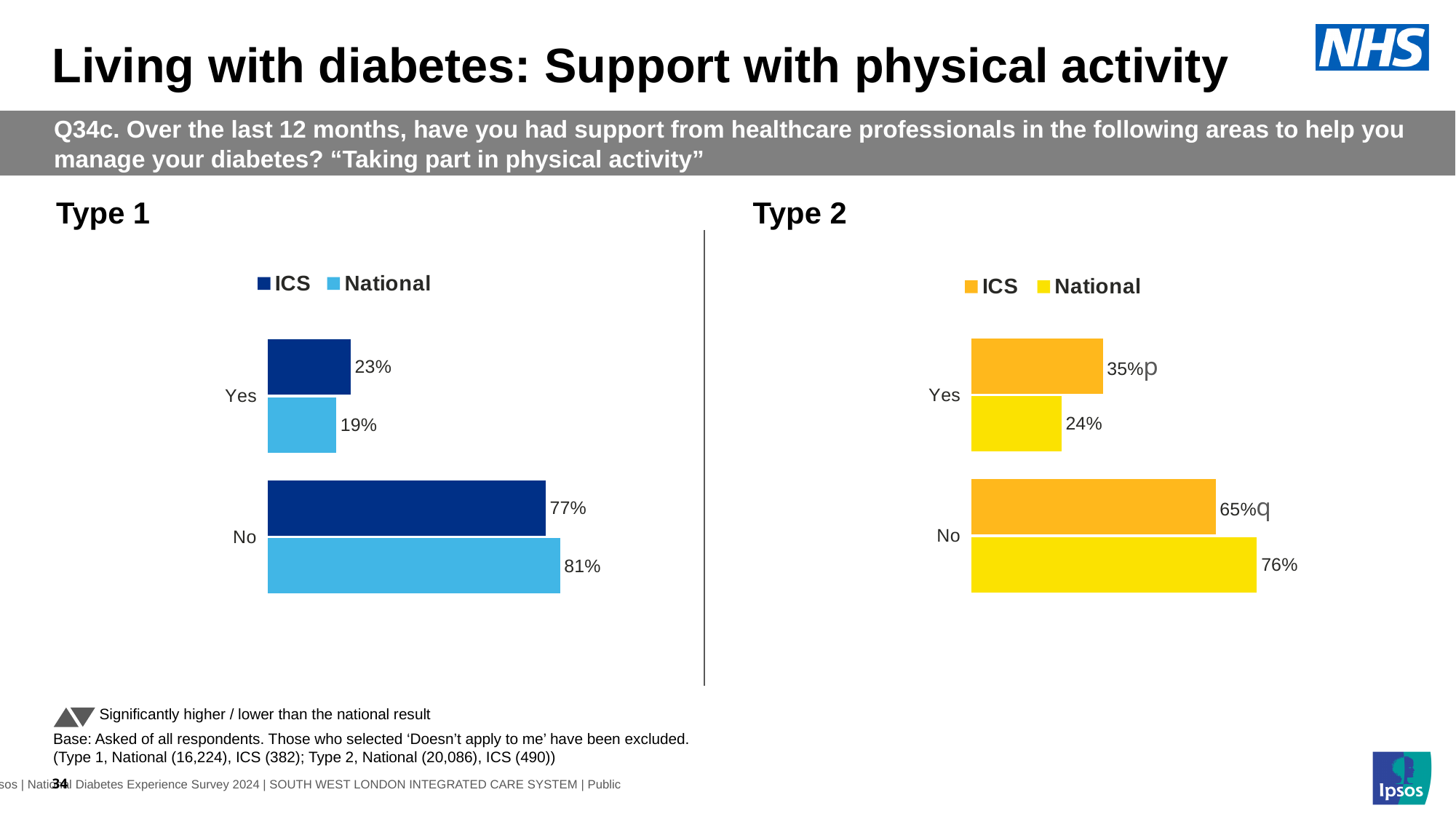
In the Type 1 chart, what is the ICS value for Yes? 23% In the Type 2 chart, which series is shown in yellow? National In the Type 2 chart, what is the National value for No? 76% In the Type 2 chart, which is larger for No: ICS or National? National In the Type 1 chart, what is the difference between the ICS and National values for No? 4% In the Type 2 chart, what is the ICS value for Yes? 35% How many categories are shown in the Type 2 chart? 2 What kind of chart is the Type 1 chart? Bar chart In the Type 1 chart, which is larger for Yes: ICS or National? ICS How many series does the legend of the Type 1 chart list? 2 In the Type 2 chart, what is the difference between the ICS and National values for Yes? 11% In the Type 1 chart, what is the National value for No? 81%